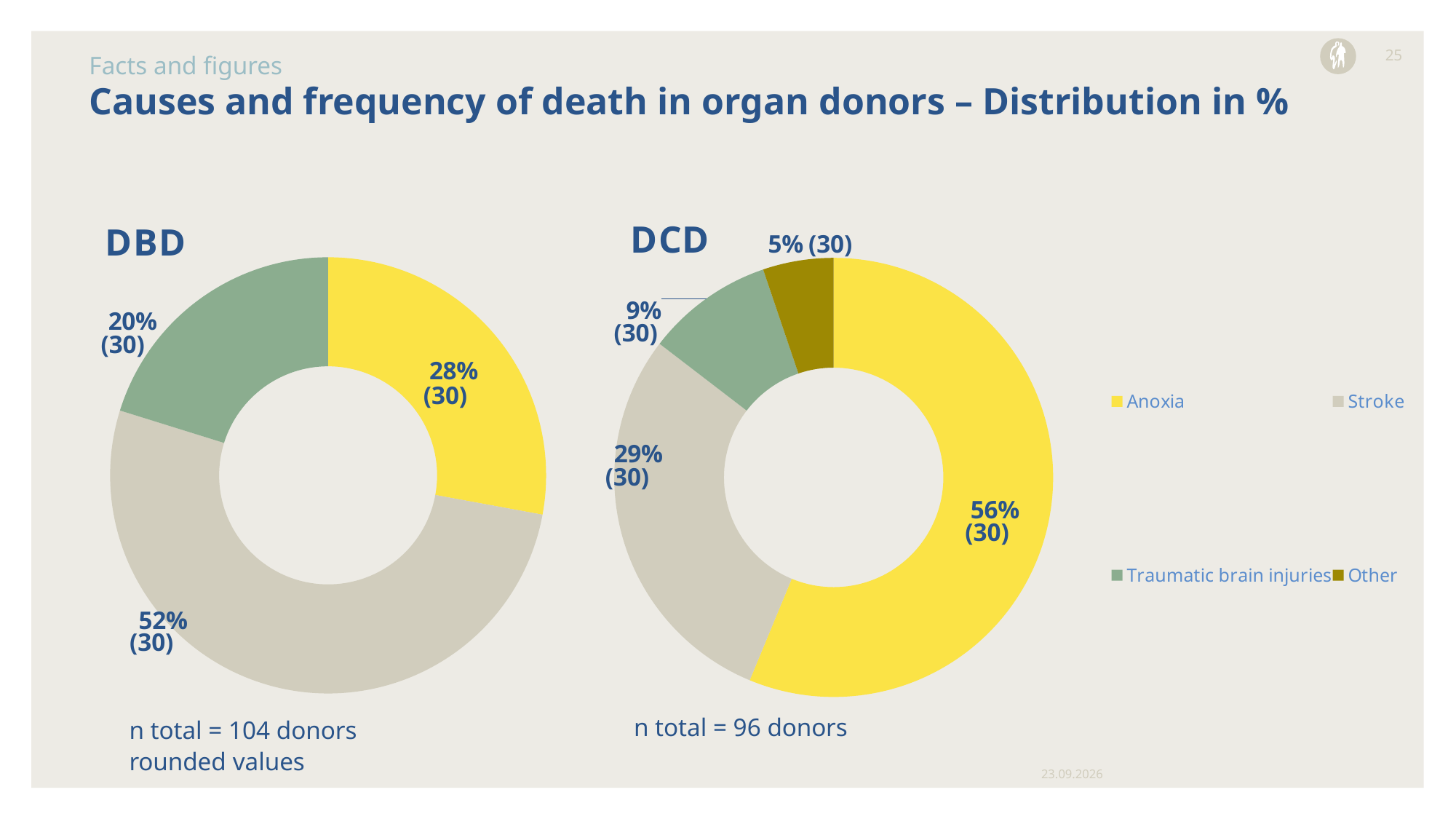
How many slices does the DBD chart have? 3 How many slices does the DCD chart have? 4 How many categories does the legend list? 4 In the DCD chart, what percentage is shown for Other? 5% In the DCD chart, what percentage is shown for Anoxia? 56% In the DBD chart, which cause of death has the largest share? Stroke Is the share of Anoxia larger in the DBD chart or the DCD chart? DCD In the DBD chart, what percentage is shown for Traumatic brain injuries? 20% What type of chart is used on this slide? Donut (pie) chart In the DCD chart, which cause of death has the smallest share? Other In the DBD chart, what percentage is shown for Stroke? 52% In the DCD chart, what is the difference in percentage points between Anoxia and Stroke? 27